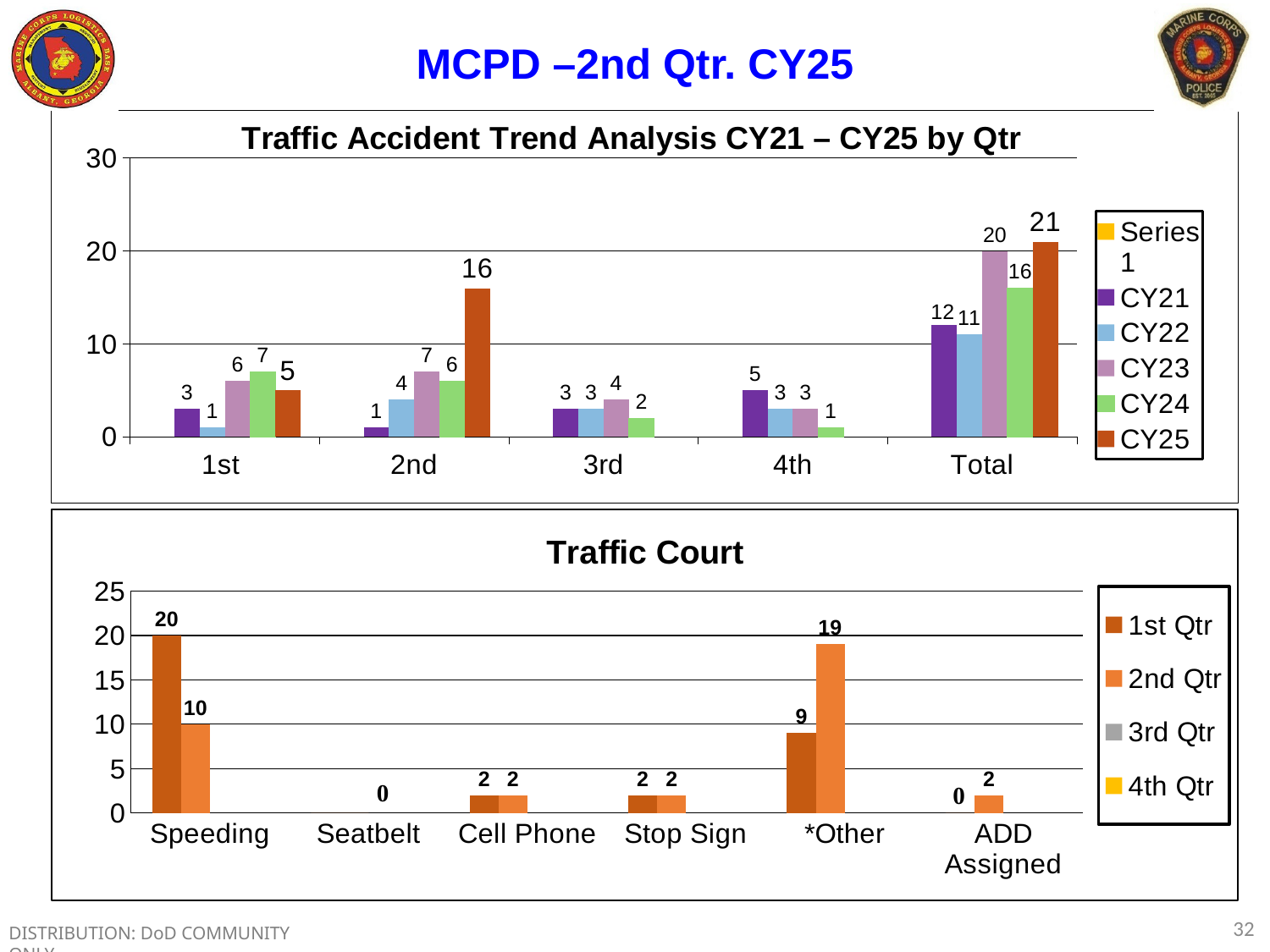
How many categories are shown on the x axis of the Traffic Court chart? 6 What type of chart is the Traffic Court chart? Bar chart In the Traffic Accident Trend Analysis chart, what is the CY21 value for the 4th quarter? 5 How many entries does the legend of the Traffic Accident Trend Analysis chart list? 6 In the Traffic Court chart, what is the 2nd Qtr value for *Other? 19 In the Traffic Accident Trend Analysis chart, which series has the highest Total value? CY25 In the Traffic Court chart, what is the 1st Qtr value for Speeding? 20 In the Traffic Accident Trend Analysis chart, which is larger for the 1st quarter: CY24 or CY21? CY24 In the Traffic Accident Trend Analysis chart, what is the difference between the CY25 and CY22 Total values? 10 In the Traffic Court chart, what is the difference between the 1st Qtr and 2nd Qtr values for Speeding? 10 In the Traffic Accident Trend Analysis chart, what is the CY23 value in the Total category? 20 In the Traffic Accident Trend Analysis chart, what is the CY25 value for the 2nd quarter? 16